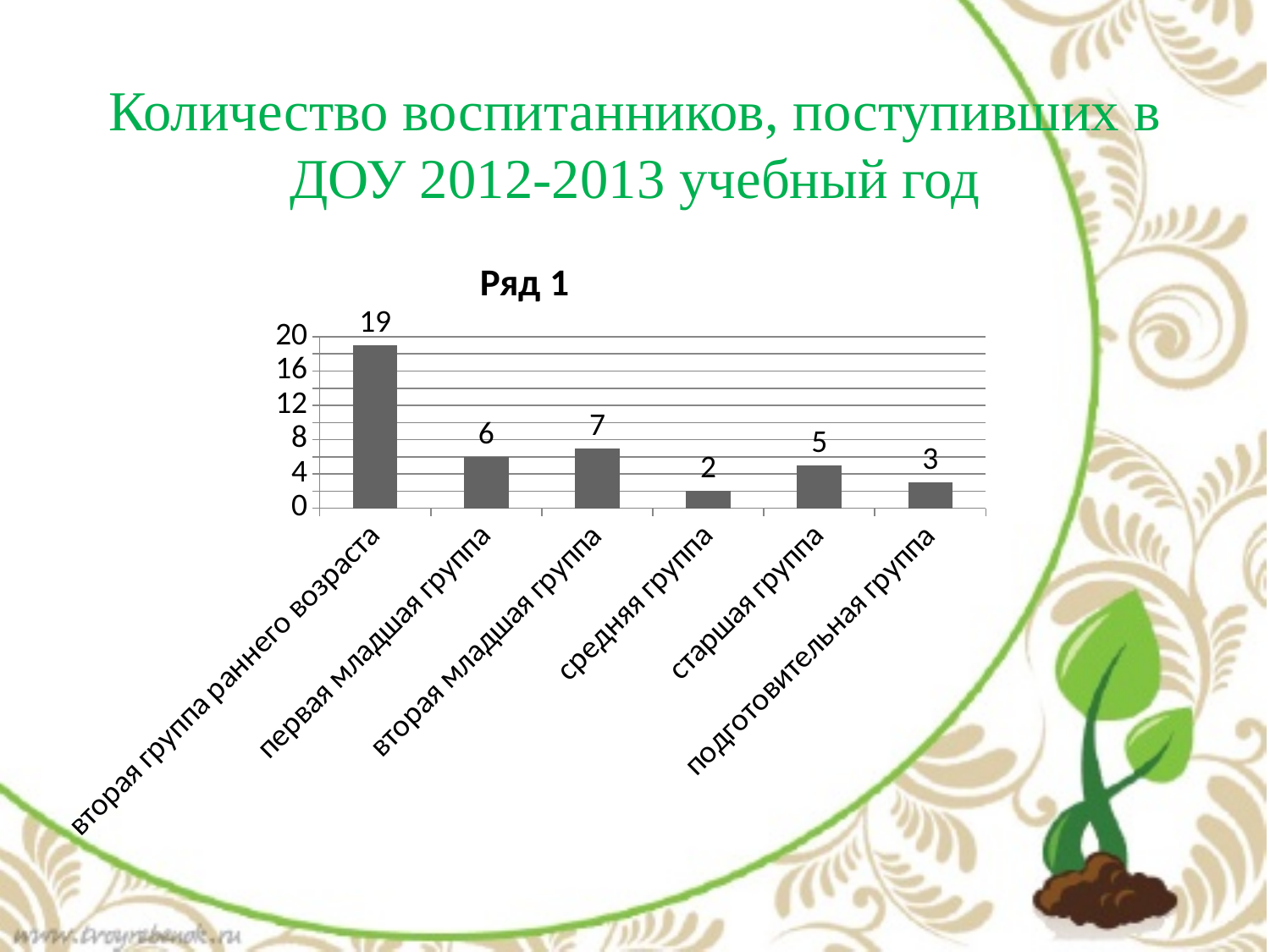
What is the value for средняя группа? 2 How many categories are shown on the x axis? 6 What kind of chart is shown on the slide? bar chart What is the value for старшая группа? 5 Which category has the lowest value? средняя группа What is the title of the chart? Ряд 1 Which is larger, the value for первая младшая группа or вторая младшая группа? вторая младшая группа What is the difference between the values for вторая группа раннего возраста and старшая группа? 14 What is the value for подготовительная группа? 3 What is the value for вторая группа раннего возраста? 19 Which category has the highest value? вторая группа раннего возраста What is the difference between the values for вторая младшая группа and средняя группа? 5